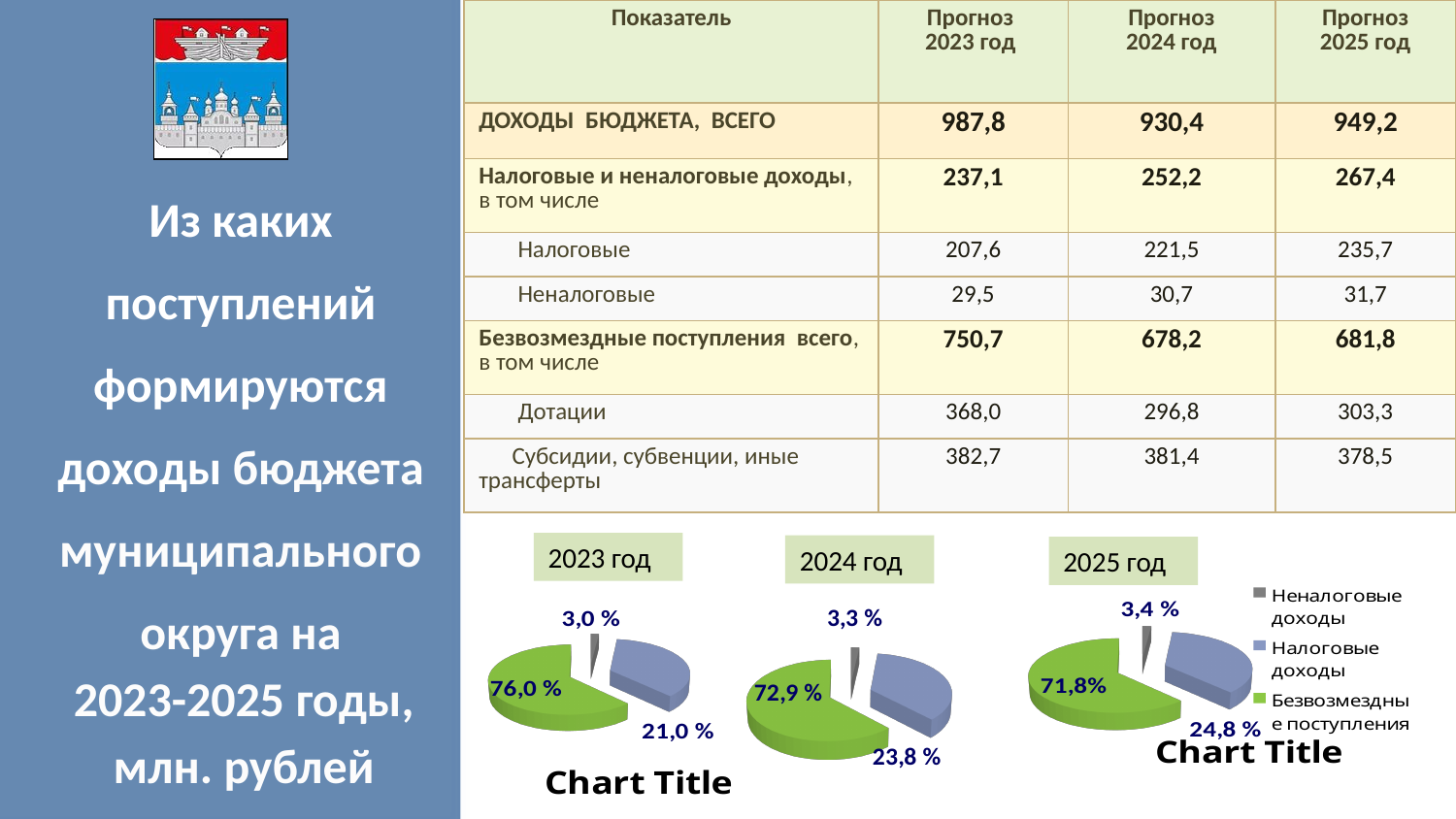
In the legend next to the 2025 год chart, which category is shown in green? Безвозмездные поступления How many entries does the legend next to the 2025 год chart list? 3 In the 2025 год pie chart, what share is shown for Неналоговые доходы? 3,4 % Is the share of Налоговые доходы larger in the 2023 год pie chart or in the 2025 год pie chart? 2025 год In the 2023 год pie chart, what is the difference between the shares of Безвозмездные поступления and Налоговые доходы? 55,0 % What type of chart is used for the 2023 год, 2024 год and 2025 год data? Pie chart In the 2024 год pie chart, which category has the largest slice? Безвозмездные поступления In the 2023 год pie chart, what share is shown for Безвозмездные поступления? 76,0 % How many slices does the 2024 год pie chart have? 3 In the 2023 год pie chart, which category has the smallest slice? Неналоговые доходы In the 2025 год pie chart, what share is shown for Безвозмездные поступления? 71,8% In the 2024 год pie chart, what share is shown for Налоговые доходы? 23,8 %